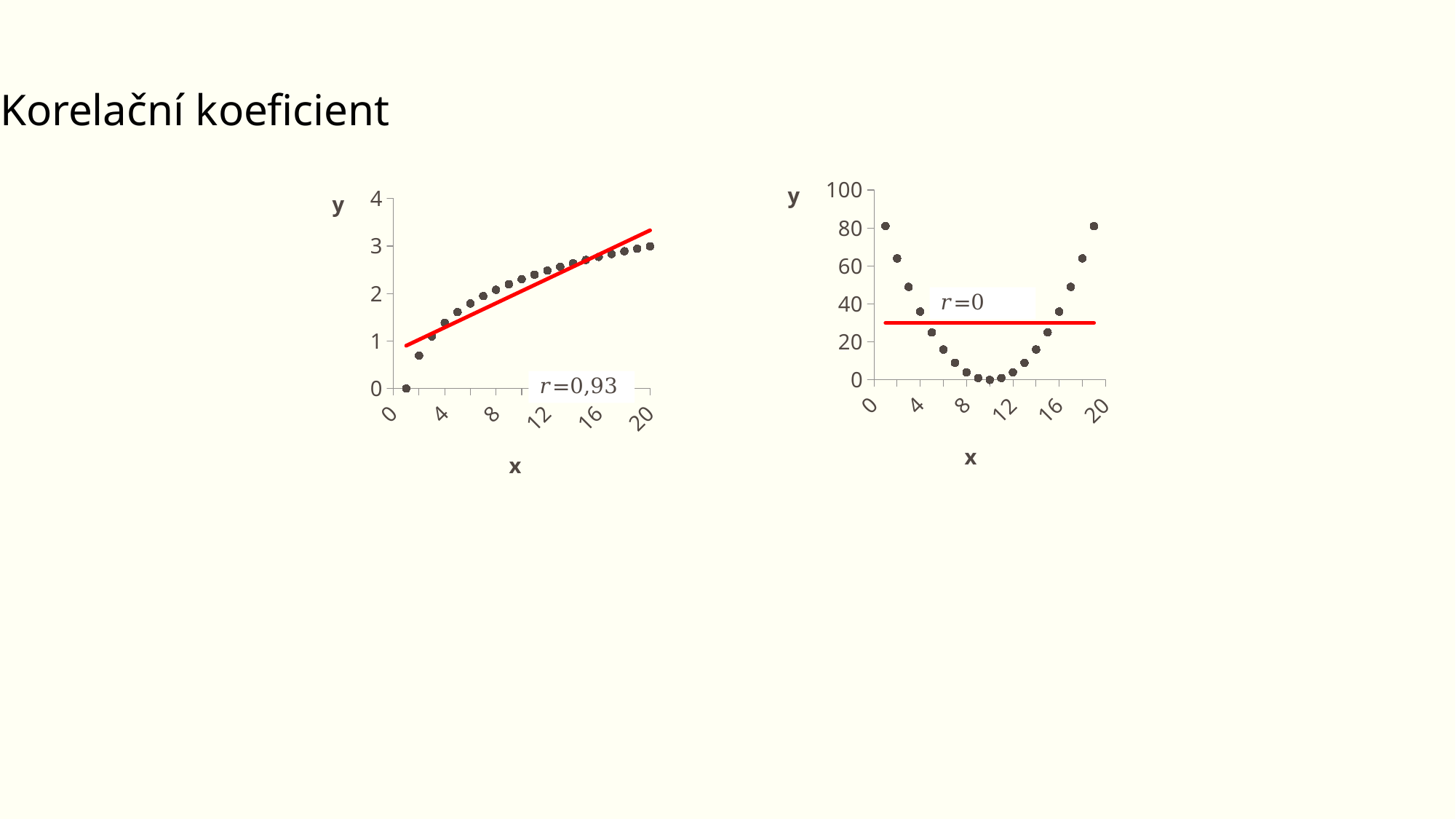
In the left chart (r=0,93), is the y value at x=2 greater or less than 1? less In the left chart (r=0,93), which has the larger y value: the point at x=2 or the point at x=18? x=18 In the left chart (r=0,93), is the y value at x=20 greater or less than 2? greater What correlation coefficient is printed on the left chart? r=0,93 In the right chart (r=0), is the y value at x=1 greater or less than 60? greater What correlation coefficient is printed on the right chart? r=0 What kind of chart is the left chart (r=0,93)? scatter chart In the left chart (r=0,93), do the y values rise or fall as x increases? rise What kind of chart is the right chart (r=0)? scatter chart In the right chart (r=0), which has the larger y value: the point at x=1 or the point at x=10? x=1